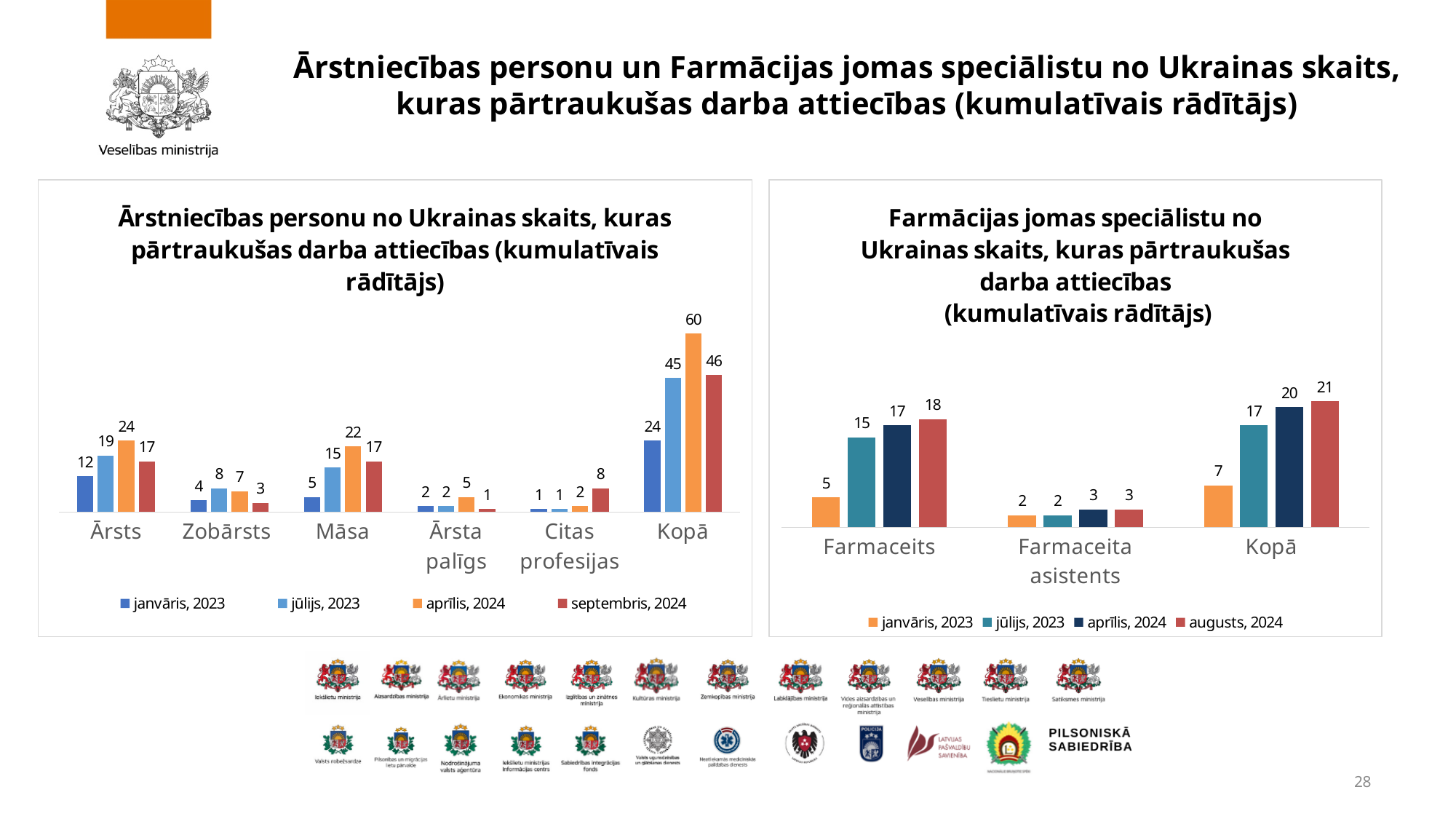
How many categories are shown on the x axis of the left chart (Ārstniecības personu no Ukrainas skaits)? 6 How many series does the legend of the left chart (Ārstniecības personu no Ukrainas skaits) list? 4 In the left chart (Ārstniecības personu no Ukrainas skaits), what is the value for Māsa in aprīlis, 2024? 22 In the right chart (Farmācijas jomas speciālistu no Ukrainas skaits), what is the value for Farmaceita asistents in janvāris, 2023? 2 In the left chart (Ārstniecības personu no Ukrainas skaits), which series has the highest value for Kopā? aprīlis, 2024 In the right chart (Farmācijas jomas speciālistu no Ukrainas skaits), what is the value for Farmaceits in augusts, 2024? 18 In the left chart (Ārstniecības personu no Ukrainas skaits), what is the difference between the Ārsts values for aprīlis, 2024 and janvāris, 2023? 12 In the left chart (Ārstniecības personu no Ukrainas skaits), what is the value for Kopā in jūlijs, 2023? 45 In the right chart (Farmācijas jomas speciālistu no Ukrainas skaits), what is the difference between the Kopā values for augusts, 2024 and janvāris, 2023? 14 In the right chart (Farmācijas jomas speciālistu no Ukrainas skaits), do the Kopā values rise or fall from janvāris, 2023 to augusts, 2024? rise In the left chart (Ārstniecības personu no Ukrainas skaits), which is larger for Citas profesijas: septembris, 2024 or aprīlis, 2024? septembris, 2024 What kind of chart is the right chart (Farmācijas jomas speciālistu no Ukrainas skaits)? bar chart